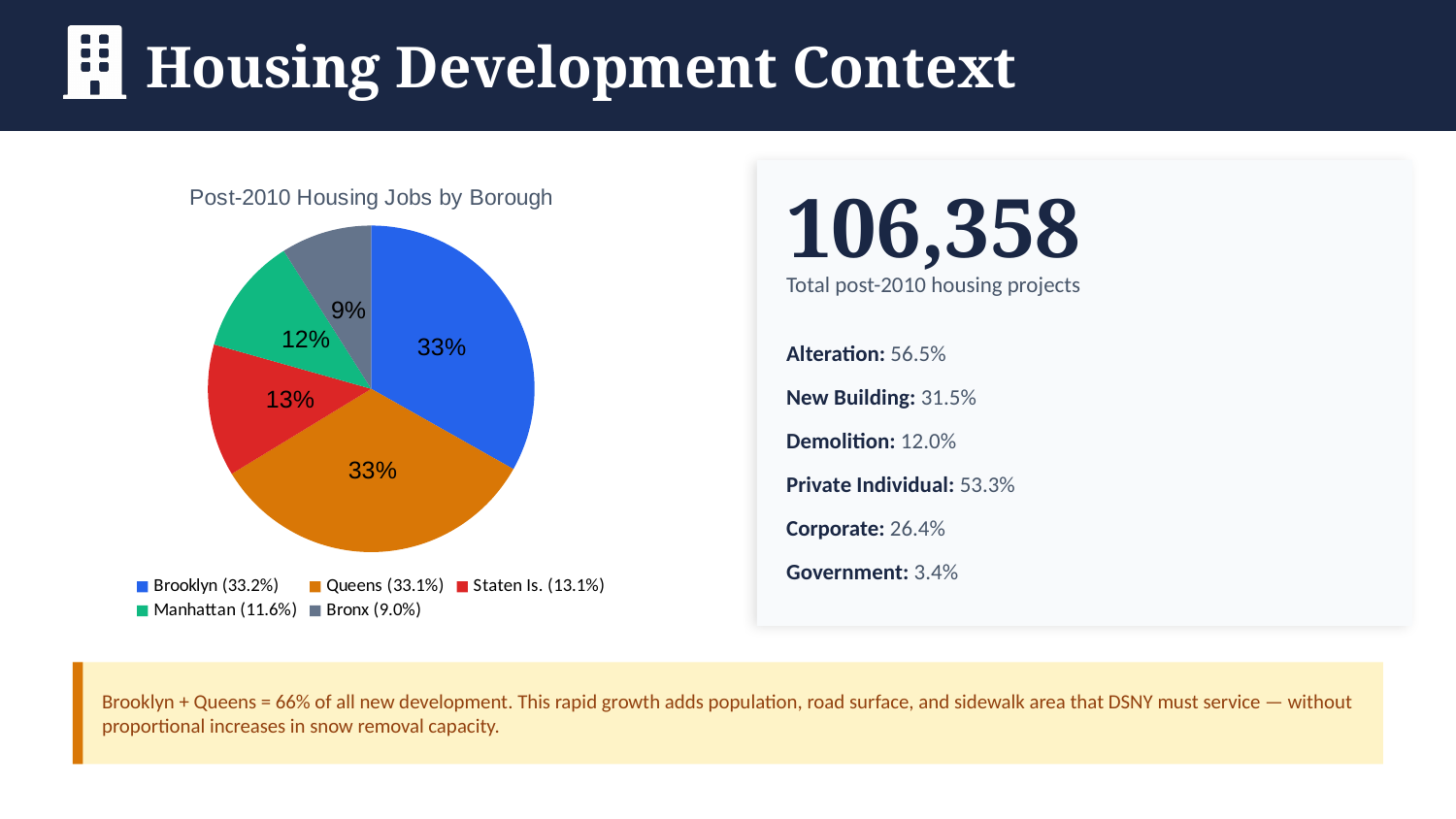
According to the legend, what percentage is shown for Manhattan? 11.6% What is the title of the pie chart? Post-2010 Housing Jobs by Borough Which borough has the smallest slice in the pie chart? Bronx Which slice is larger, Brooklyn or Bronx? Brooklyn According to the legend, what percentage of post-2010 housing jobs is attributed to Brooklyn? 33.2% Using the slice data labels, what is the difference between the Staten Is. slice (13%) and the Bronx slice (9%)? 4% What data label is printed on the Staten Is. slice of the pie chart? 13% What share of the pie does the Bronx slice represent, according to the legend? 9.0% According to the legend, what percentage of post-2010 housing jobs is attributed to Queens? 33.1% What colour is the Queens slice in the pie chart? orange What type of chart is shown on the slide? pie chart How many boroughs (slices) does the pie chart show? 5